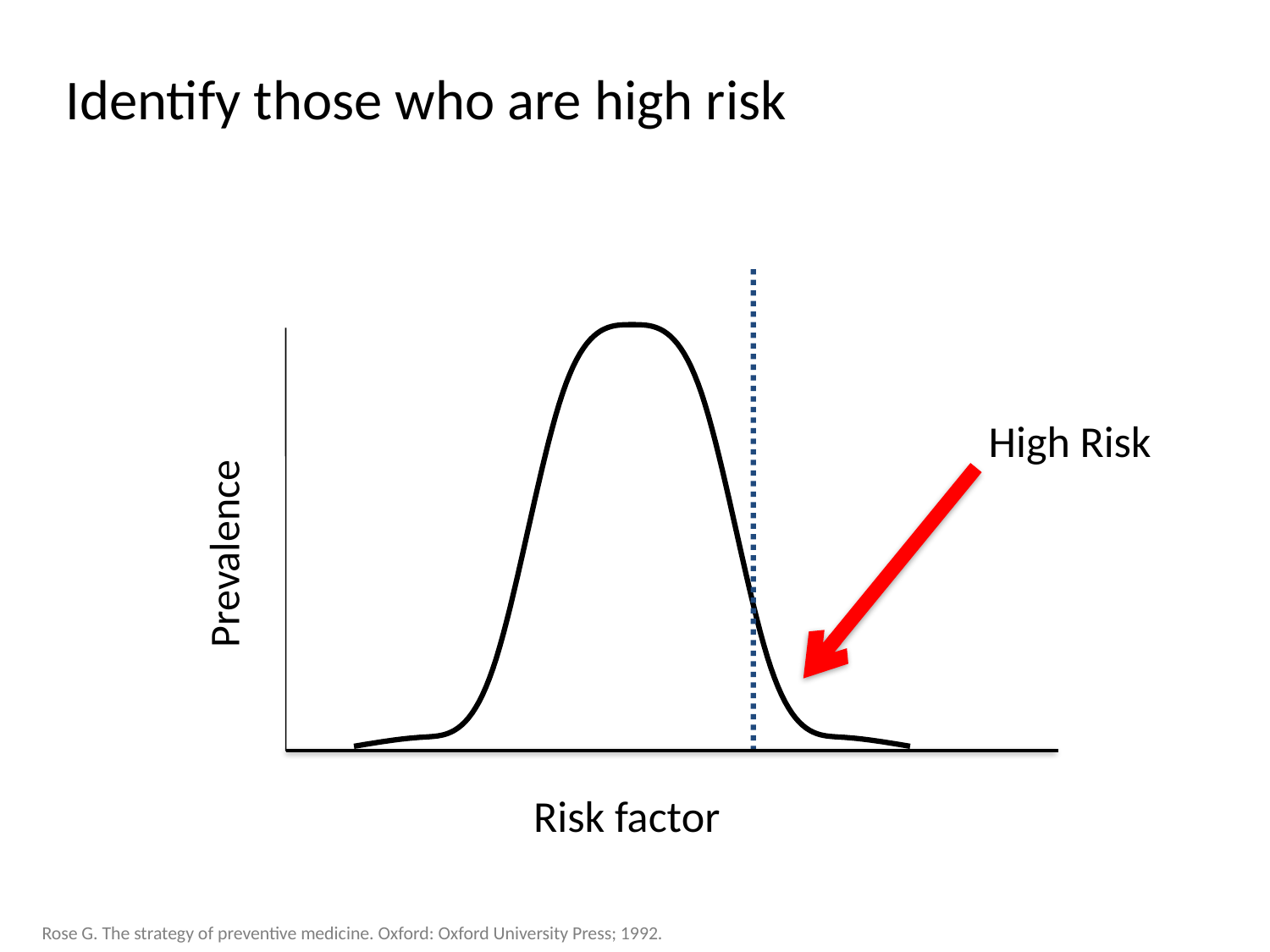
Is the region labelled "High Risk" to the left or to the right of the dotted vertical line? right What kind of chart is shown on the slide? line chart What is the label of the vertical axis of the chart? Prevalence What is the label of the horizontal axis of the chart? Risk factor Moving left to right along the x axis, does the curve rise then fall, or fall then rise? rise then fall